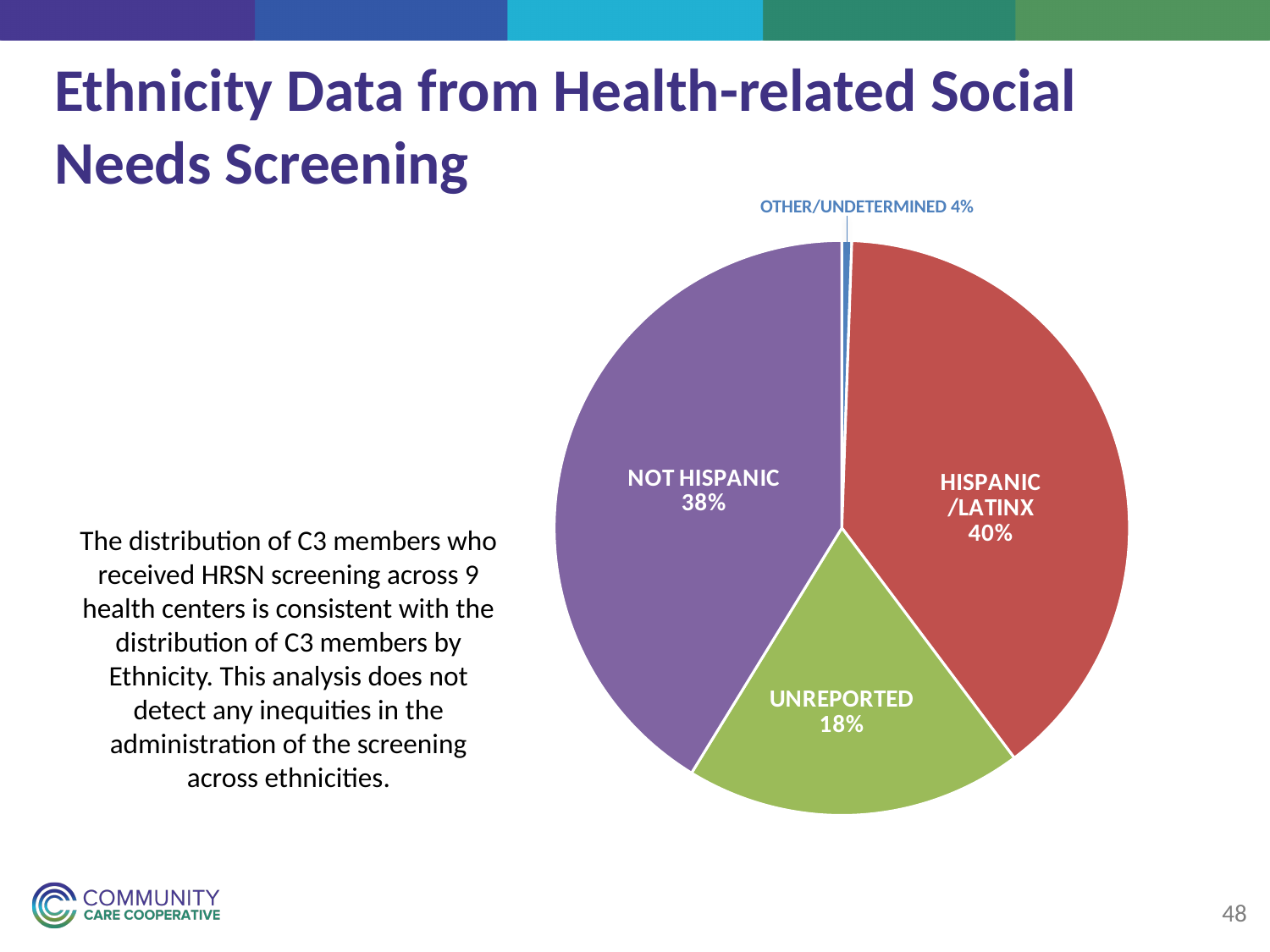
What share of the pie is Other/Undetermined? 4% What colour is the Unreported slice? Green What share of the pie is Unreported? 18% Which is larger, the Unreported slice or the Other/Undetermined slice? Unreported What is the difference in percentage points between the Hispanic/Latinx and Not Hispanic slices? 2 percentage points Which category has the largest slice of the pie? Hispanic/Latinx What kind of chart is shown on the slide? Pie chart What share of the pie is Hispanic/Latinx? 40% Which category has the smallest slice of the pie? Other/Undetermined How many categories are shown in the pie chart? 4 What is the difference in percentage points between the Not Hispanic and Unreported slices? 20 percentage points